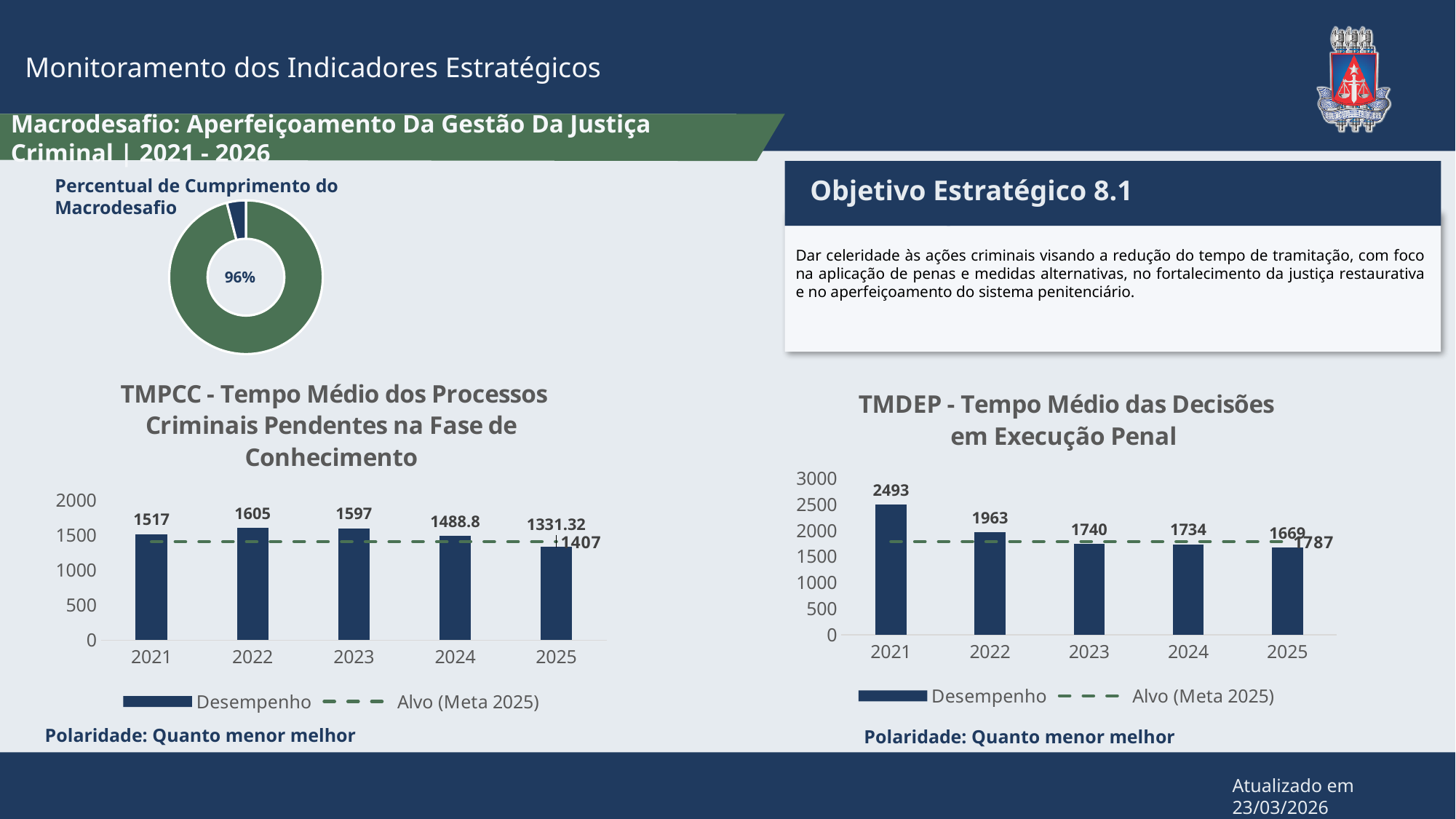
In the TMDEP chart, what is the Alvo (Meta 2025) value? 1787 In the TMPCC chart, which year has the highest Desempenho value? 2022 In the TMDEP chart, what is the difference between the 2021 and 2022 Desempenho values? 530 In the TMDEP chart, which year has the lowest Desempenho value? 2025 In the TMPCC chart, what is the Desempenho value for 2022? 1605 What percentage is shown in the centre of the 'Percentual de Cumprimento do Macrodesafio' donut chart? 96% In the TMDEP chart, what is the Desempenho value for 2021? 2493 In the TMPCC chart, what is the Desempenho value for 2025? 1331.32 How many years are shown on the x axis of the TMPCC chart? 5 In the TMPCC chart, what is the Alvo (Meta 2025) value? 1407 In the TMDEP chart, do the Desempenho values rise or fall from 2021 to 2025? fall In the TMPCC chart, what is the difference between the 2021 and 2024 Desempenho values? 28.2